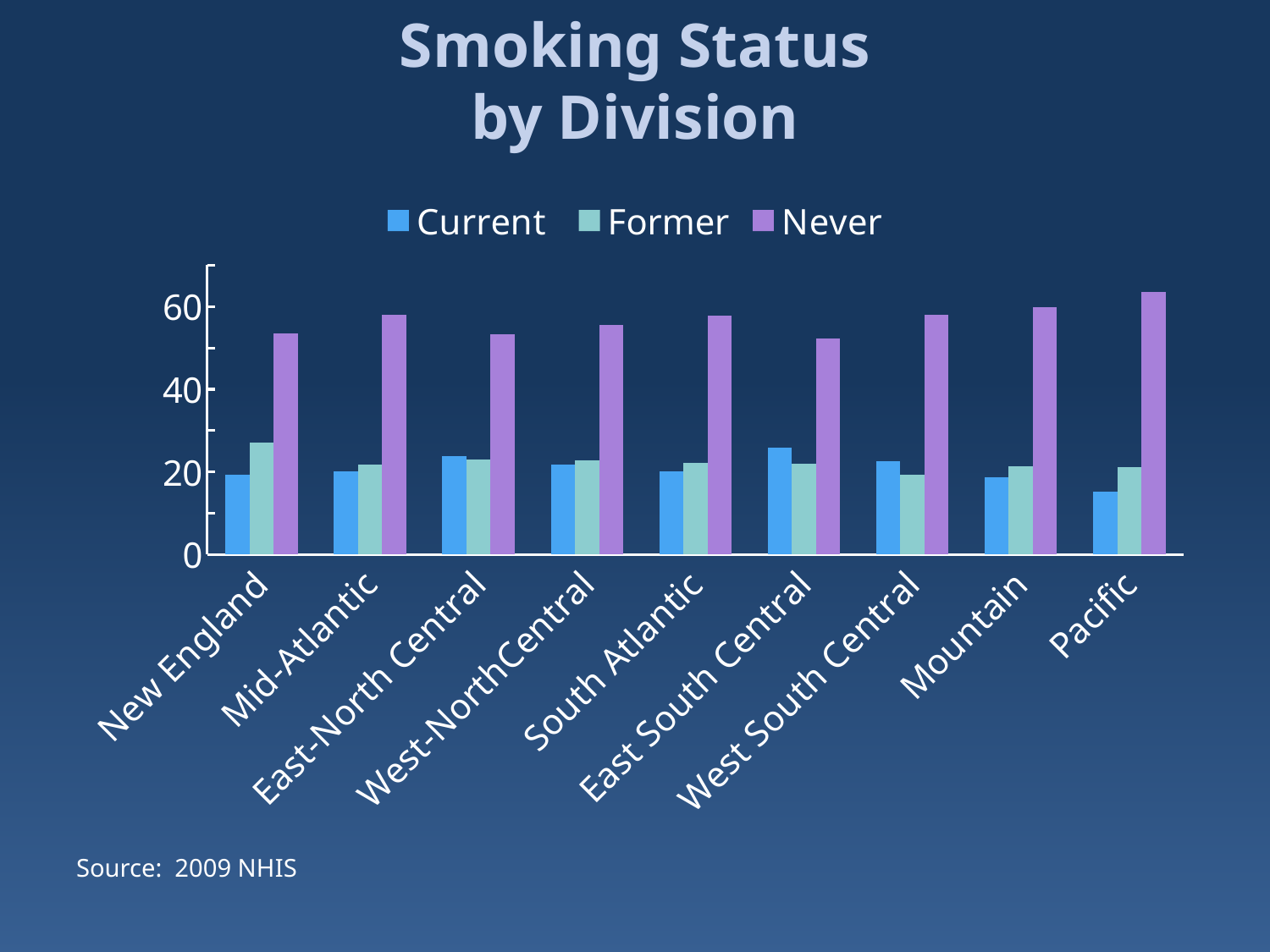
Is the Never value for Pacific greater or less than 60? greater Which division has the highest Never value? Pacific Which division has the lowest Current value? Pacific For New England, which is larger, the Current value or the Former value? Former Which is larger, the Never value for Mountain or the Never value for New England? Mountain How many series does the legend list? 3 What is the source cited for the chart? 2009 NHIS Is the Never value for New England greater or less than 60? less What kind of chart is shown on the slide? Bar chart Which division has the highest Former value? New England How many divisions are shown on the x axis? 9 Is the Current value for Pacific greater or less than 20? less